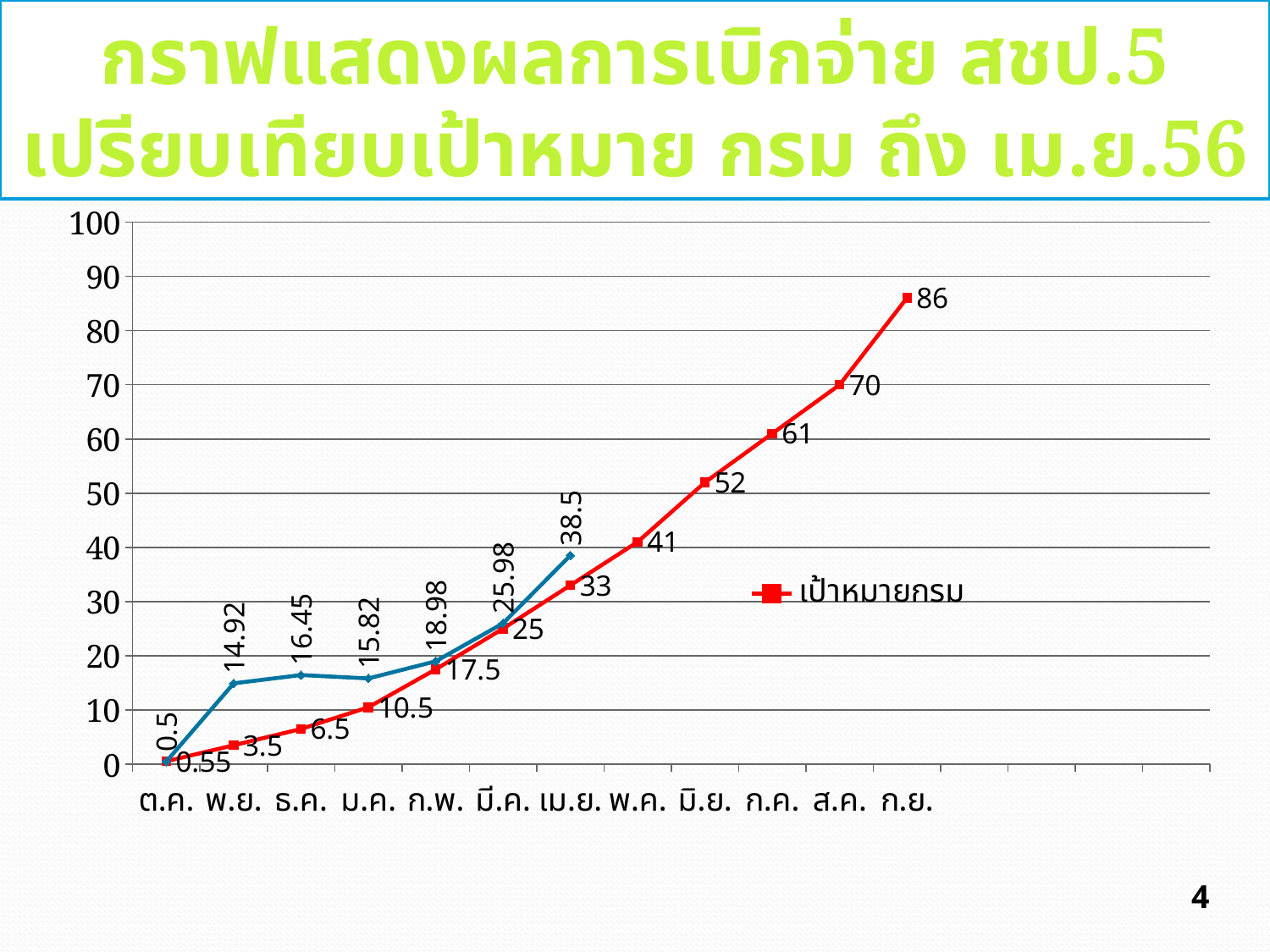
What is the value of เป้าหมายกรม for ก.ย.? 86 How many months are shown on the x axis? 12 What is the value of the blue line for พ.ย.? 14.92 In which month does เป้าหมายกรม reach its highest value? ก.ย. Does the เป้าหมายกรม line rise or fall from ต.ค. to ก.ย.? rise What is the difference between the blue line value and the เป้าหมายกรม value for เม.ย.? 5.5 What is the value of the blue line for เม.ย.? 38.5 How many series does the legend list? 1 What is the value of เป้าหมายกรม for ม.ค.? 10.5 What is the difference between the เป้าหมายกรม values for ก.ย. and ส.ค.? 16 For มี.ค., which is larger: the blue line value or the เป้าหมายกรม value? the blue line (25.98) What kind of chart is shown on the slide? line chart